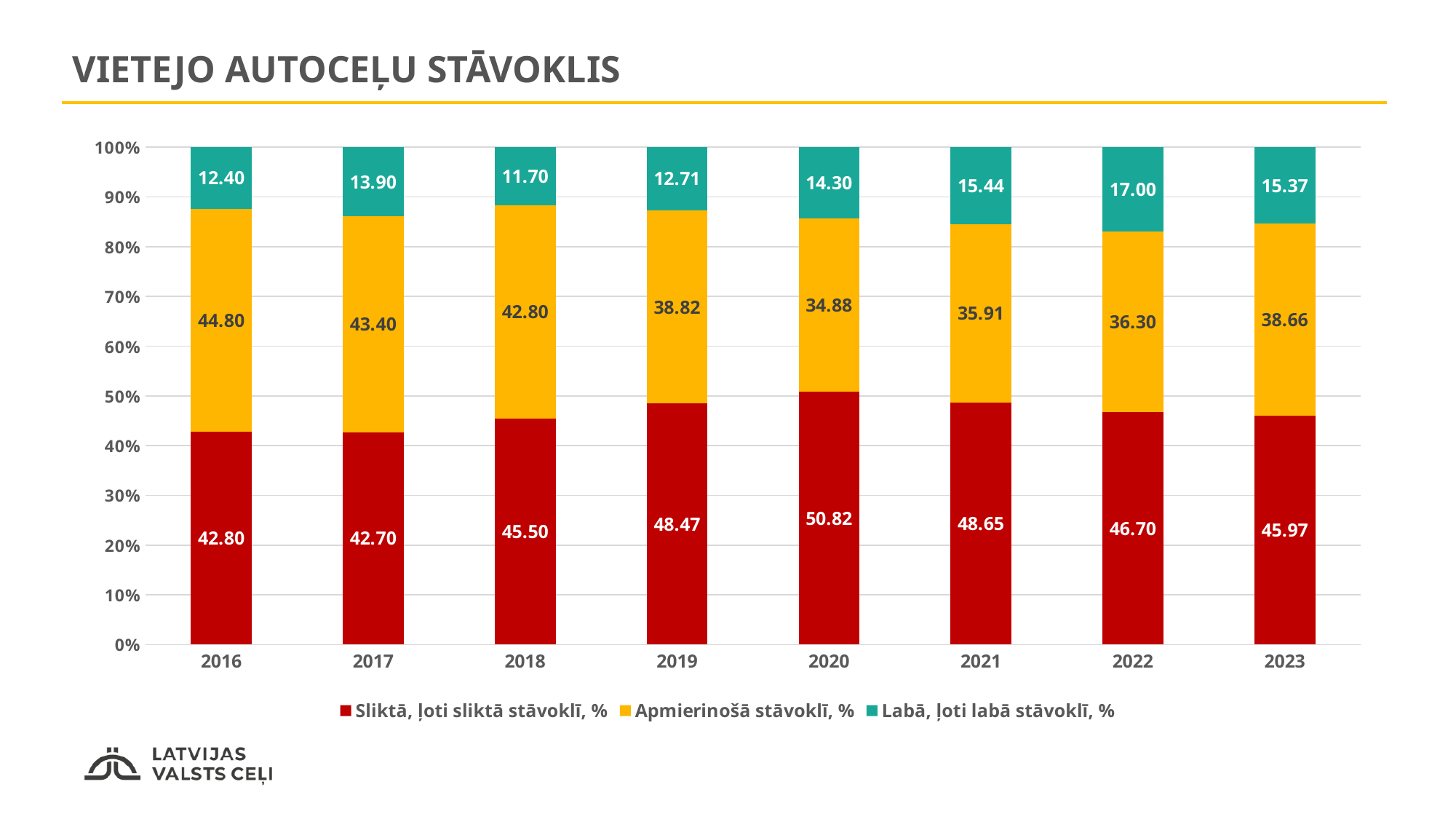
What is the value for 'Sliktā, ļoti sliktā stāvoklī, %' in 2020? 50.82 What is the difference between the 'Labā, ļoti labā stāvoklī, %' values in 2022 and 2016? 4.60 How many series does the legend list? 3 What is the value for 'Labā, ļoti labā stāvoklī, %' in 2022? 17.00 Which is larger: the 'Apmierinošā stāvoklī, %' value in 2019 or in 2023? 2019 In which year is the 'Sliktā, ļoti sliktā stāvoklī, %' value highest? 2020 What is the value for 'Apmierinošā stāvoklī, %' in 2016? 44.80 Does the 'Apmierinošā stāvoklī, %' value rise or fall from 2016 to 2020? Fall How many years are shown on the x axis? 8 What kind of chart is shown on the slide? Stacked bar chart What is the title of the chart? VIETEJO AUTOCEĻU STĀVOKLIS In which year is the 'Labā, ļoti labā stāvoklī, %' value lowest? 2018